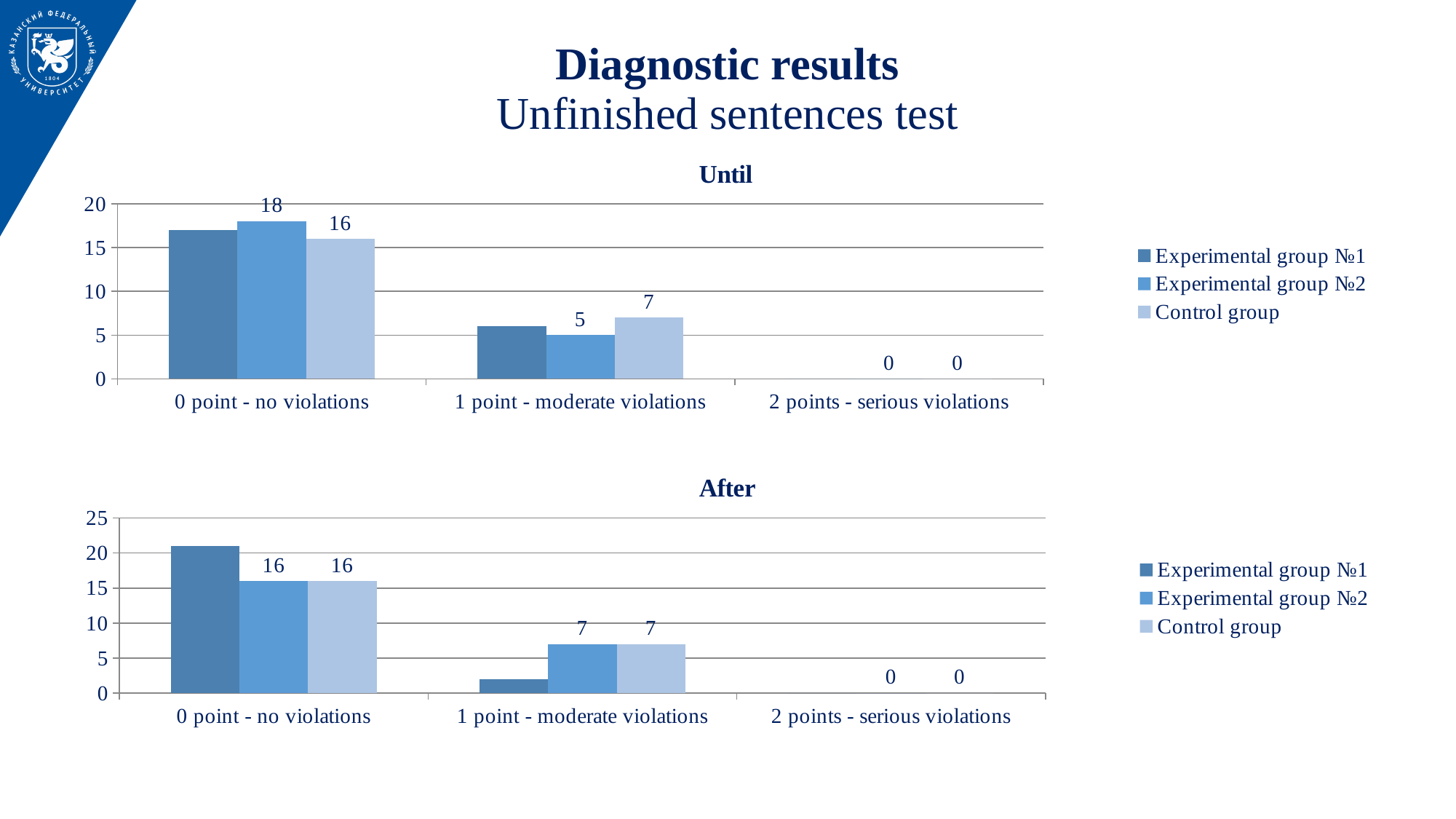
In the 'Until' chart, which is larger at '1 point - moderate violations': Experimental group №2 or the Control group? Control group In the 'Until' chart, what is the value for the Control group at '1 point - moderate violations'? 7 How many categories are shown on the x axis of the 'Until' chart? 3 In the 'Until' chart, what is the difference between Experimental group №2 and the Control group at '0 point - no violations'? 2 In the 'Until' chart, what is the value for Experimental group №2 at '0 point - no violations'? 18 In the 'After' chart, what is the value for the Control group at '0 point - no violations'? 16 In the 'After' chart, is the value for Experimental group №1 at '0 point - no violations' greater or less than 20? greater What kind of chart is the 'Until' chart? bar chart In the 'After' chart, what is the value for Experimental group №2 at '1 point - moderate violations'? 7 In the 'After' chart, which series has the highest value at '0 point - no violations'? Experimental group №1 In the 'After' chart, is the value for Experimental group №1 at '1 point - moderate violations' greater or less than 5? less How many series does the legend of the 'After' chart list? 3